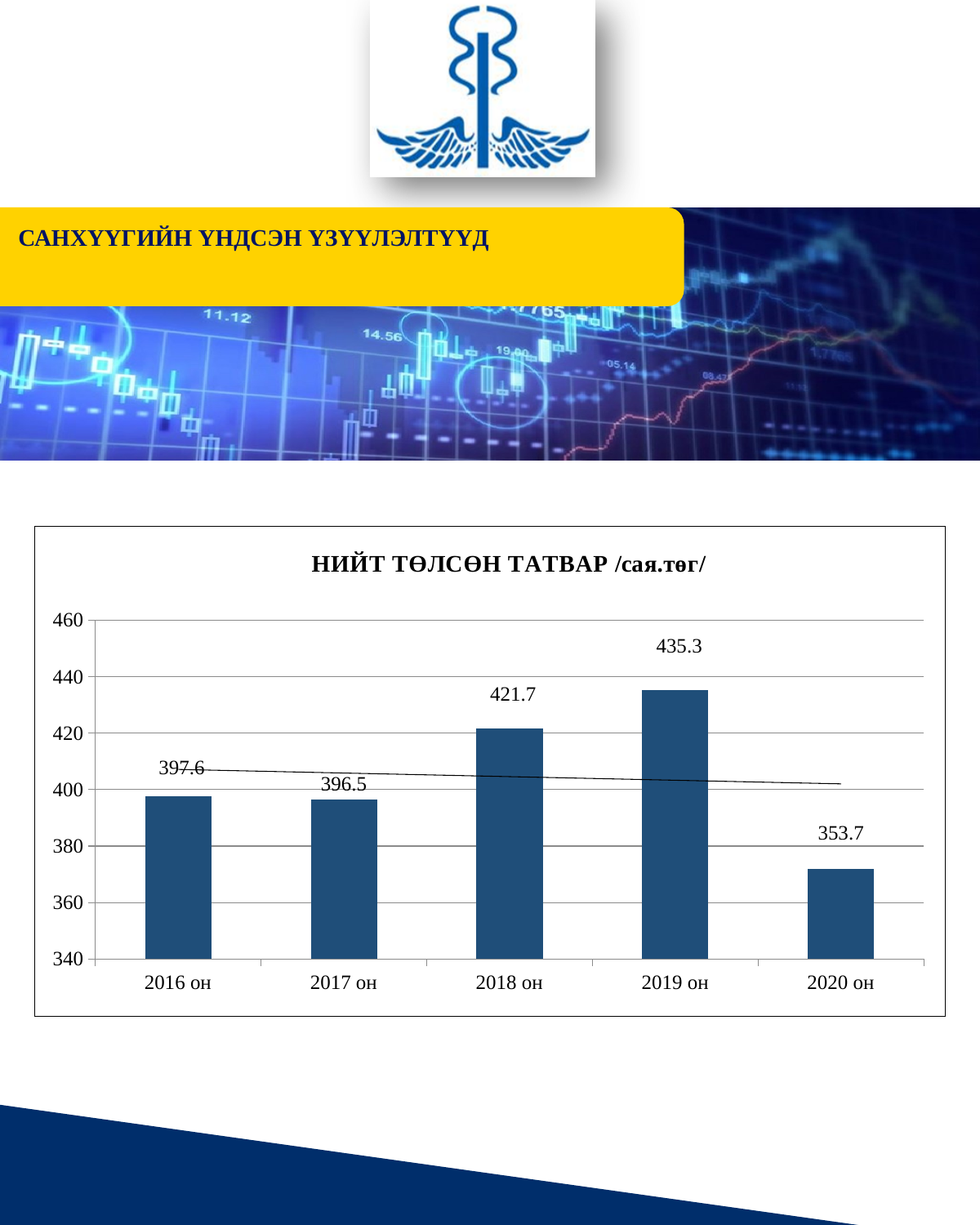
What is the value for 2017 он in the chart 'НИЙТ ТӨЛСӨН ТАТВАР /сая.төг/'? 396.5 What is the value for 2019 он in the chart 'НИЙТ ТӨЛСӨН ТАТВАР /сая.төг/'? 435.3 Does the straight trend line drawn across the chart 'НИЙТ ТӨЛСӨН ТАТВАР /сая.төг/' slope upward or downward from left to right? downward What kind of chart is 'НИЙТ ТӨЛСӨН ТАТВАР /сая.төг/'? bar chart Which year has the lowest value in the chart 'НИЙТ ТӨЛСӨН ТАТВАР /сая.төг/'? 2020 он Which year has the highest value in the chart 'НИЙТ ТӨЛСӨН ТАТВАР /сая.төг/'? 2019 он How many years are shown on the x axis of the chart 'НИЙТ ТӨЛСӨН ТАТВАР /сая.төг/'? 5 What is the difference between the values for 2016 он and 2017 он in the chart 'НИЙТ ТӨЛСӨН ТАТВАР /сая.төг/'? 1.1 Which is larger in the chart 'НИЙТ ТӨЛСӨН ТАТВАР /сая.төг/': the value for 2018 он or the value for 2016 он? 2018 он What is the value labelled for 2020 он in the chart 'НИЙТ ТӨЛСӨН ТАТВАР /сая.төг/'? 353.7 What is the difference between the values for 2019 он and 2018 он in the chart 'НИЙТ ТӨЛСӨН ТАТВАР /сая.төг/'? 13.6 Is the value for 2018 он greater or less than 420 in the chart 'НИЙТ ТӨЛСӨН ТАТВАР /сая.төг/'? greater